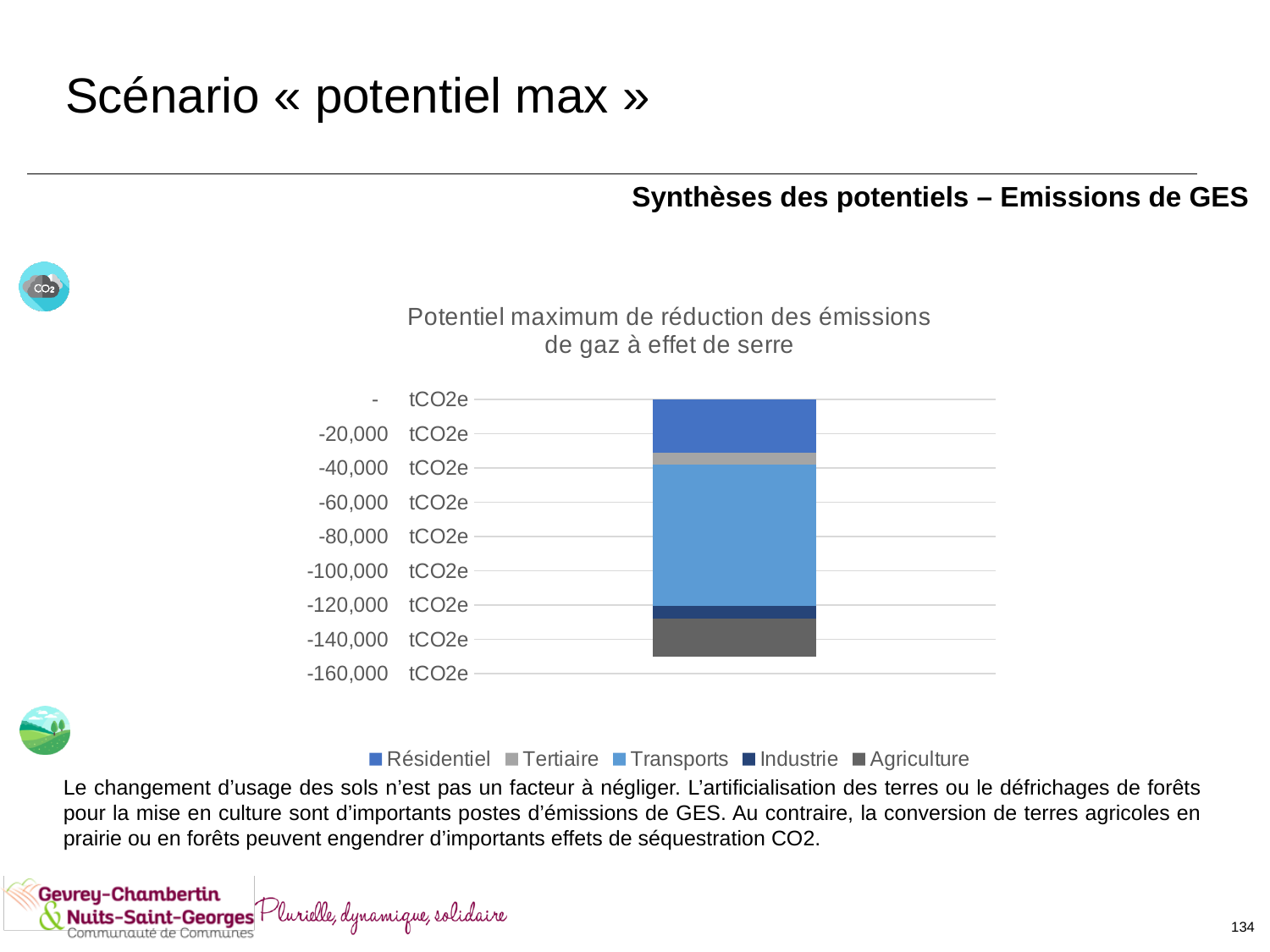
Is the size of the Transports segment greater or less than 60,000 tCO2e? greater What is the title of the chart? Potentiel maximum de réduction des émissions de gaz à effet de serre Which series is listed last in the chart legend? Agriculture What unit is shown on the vertical axis of the chart? tCO2e What kind of chart is shown on the slide? Stacked bar chart How many series does the chart legend list? 5 Is the size of the Résidentiel segment greater or less than 20,000 tCO2e? greater Which segment is larger in the stacked bar, Transports or Résidentiel? Transports Which series accounts for the largest segment of the stacked bar? Transports Which segment is larger in the stacked bar, Résidentiel or Tertiaire? Résidentiel Is the bottom of the stacked bar greater or less than -140,000 tCO2e? less How many stacked bars are plotted in the chart? 1